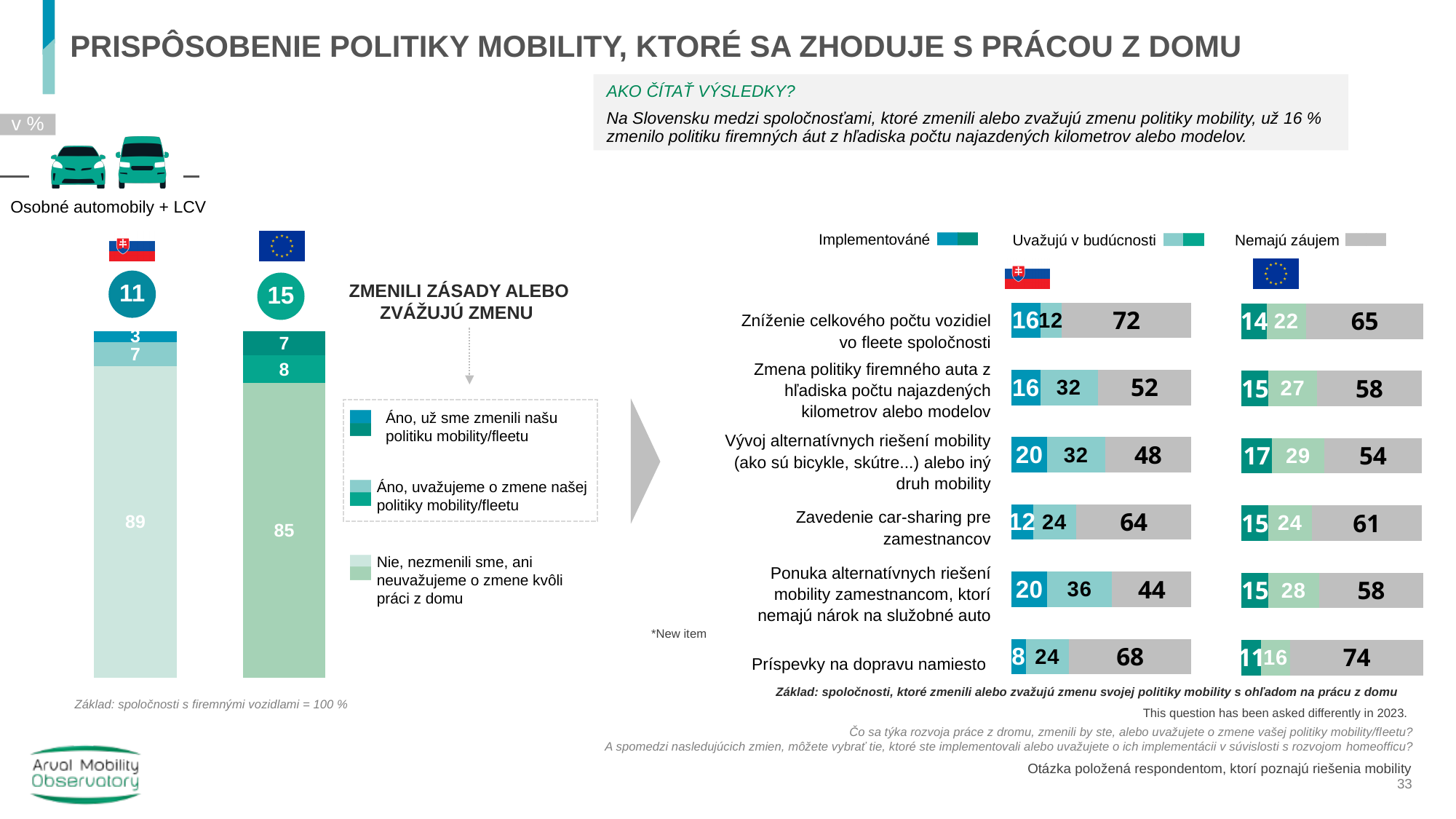
In the left chart, what percentage of Slovak companies answered 'Nie, nezmenili sme, ani neuvažujeme o zmene kvôli práci z domu'? 89 In the right chart, which item has the lowest Slovak 'Implementované' value? Príspevky na dopravu namiesto How many series does the legend of the right chart list? 3 What kind of chart is used on the right side of the slide? Bar chart In the right chart, what is the EU 'Nemajú záujem' value for 'Príspevky na dopravu namiesto'? 74 In the right chart, for 'Zavedenie car-sharing pre zamestnancov', is the 'Implementované' value higher for Slovakia or for the EU? EU In the left chart, what is the difference between the Slovak and EU values for 'Nie, nezmenili sme, ani neuvažujeme o zmene kvôli práci z domu'? 4 In the right chart, what is the Slovak 'Implementované' value for 'Ponuka alternatívnych riešení mobility zamestnancom, ktorí nemajú nárok na služobné auto'? 20 In the right chart, which item has the highest Slovak 'Nemajú záujem' value? Zníženie celkového počtu vozidiel vo fleete spoločnosti How many items (categories) are shown in the right chart? 6 In the right chart, what is the combined Slovak 'Implementované' and 'Uvažujú v budúcnosti' value for 'Zmena politiky firemného auta z hľadiska počtu najazdených kilometrov alebo modelov'? 48 In the left chart, what is the EU value for 'Áno, už sme zmenili našu politiku mobility/fleetu'? 7